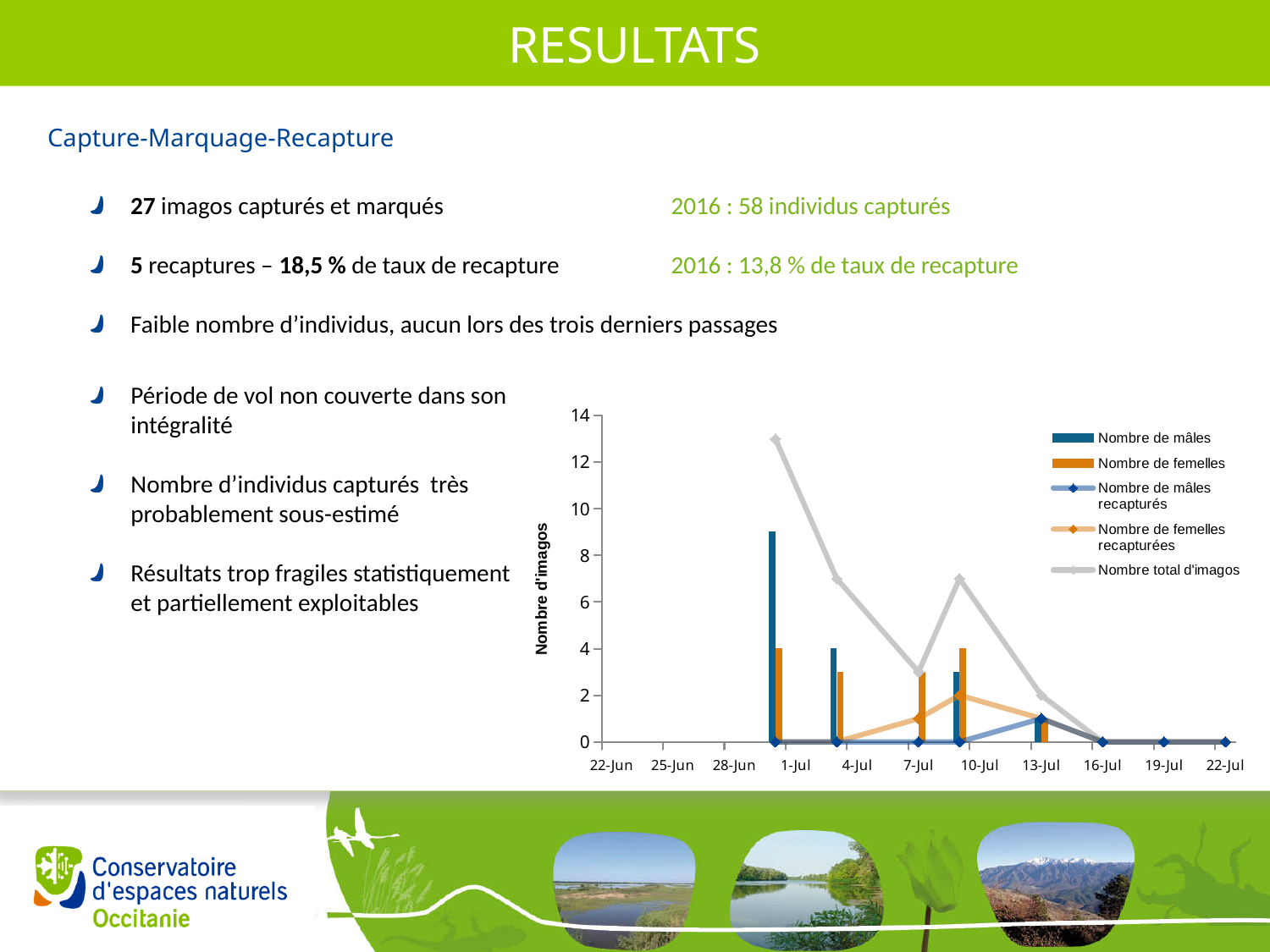
Which series reaches the highest value on the chart? Nombre total d'imagos Which colour is used for the Nombre de femelles bars? orange How many series does the chart legend list? 5 At the first capture date (just before 1-Jul), which bar is taller: Nombre de mâles or Nombre de femelles? Nombre de mâles Is the highest value of the Nombre total d'imagos line greater or less than 12? greater Does the Nombre total d'imagos line rise or fall between 1-Jul and 7-Jul? fall How many date labels are shown on the x axis of the chart? 11 What kind of chart is shown on the slide? bar and line chart Is the highest point of the Nombre de femelles recapturées line greater or less than 4? less What is the value of Nombre total d'imagos at 22-Jul? 0 Is the tallest Nombre de mâles bar greater or less than 8? greater What is the title of the vertical axis of the chart? Nombre d'imagos